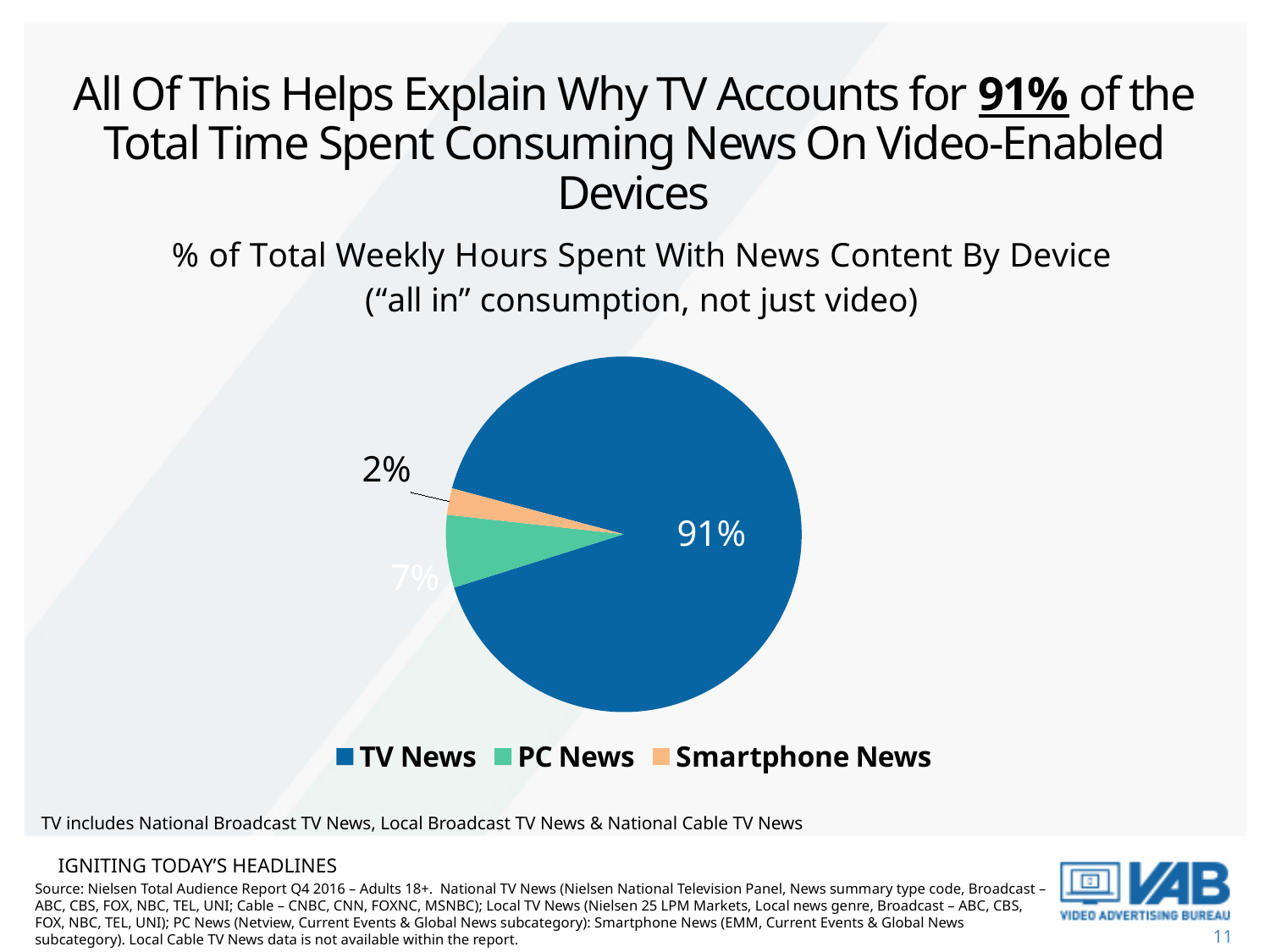
How many categories does the legend list? 3 What is the difference in percentage points between the TV News share and the PC News share? 84 What is the combined share of PC News and Smartphone News? 9% Which has a larger share, PC News or Smartphone News? PC News What colour represents TV News in the pie chart? blue What share of total weekly hours spent with news content is attributed to PC News? 7% What kind of chart is shown on the slide? pie chart Which device category has the largest share of the pie? TV News Which device category has the smallest share of the pie? Smartphone News What share of total weekly hours spent with news content is attributed to Smartphone News? 2% What share of total weekly hours spent with news content is attributed to TV News? 91% What is the difference in percentage points between the PC News share and the Smartphone News share? 5